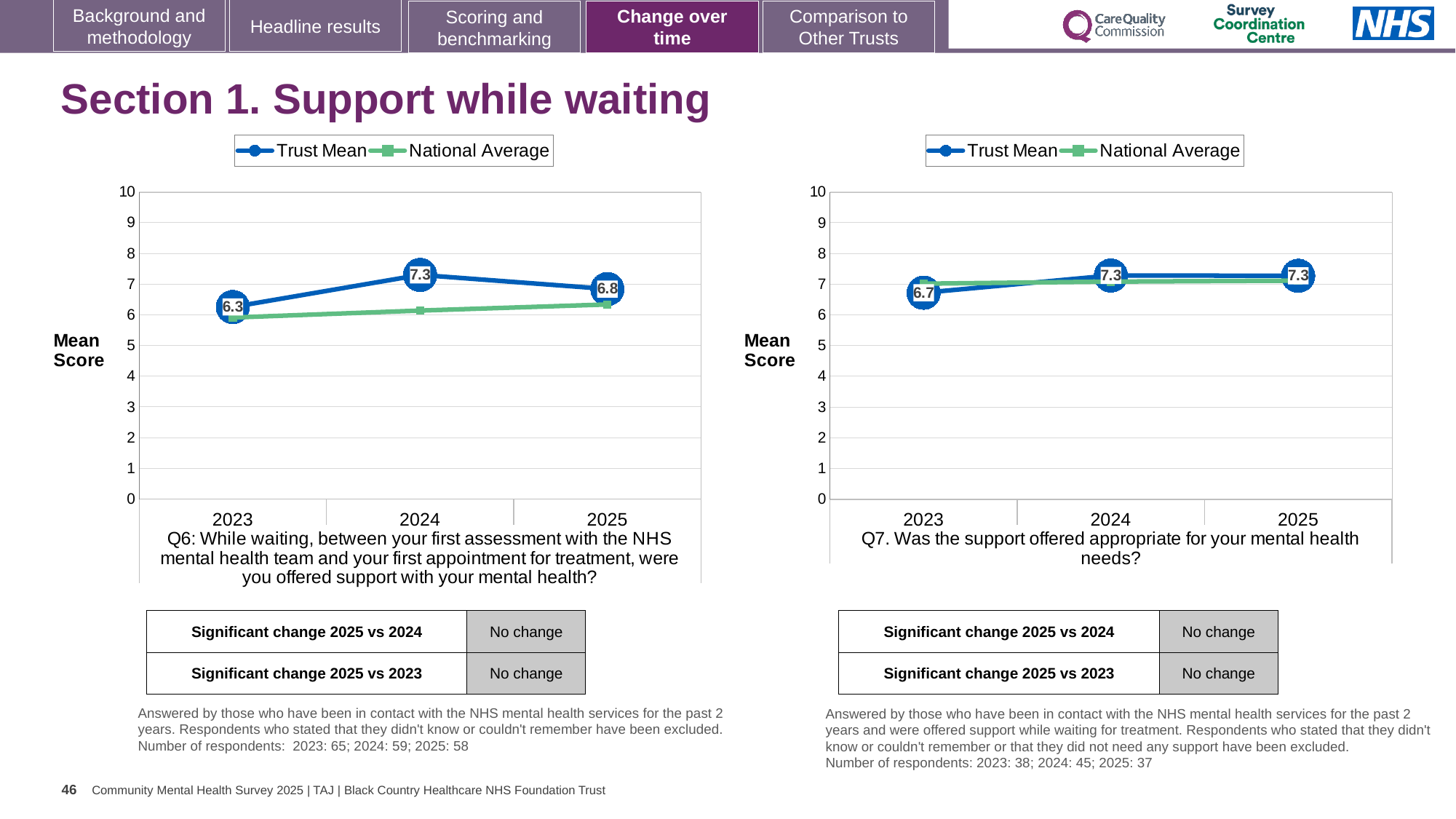
On the Q6 chart (left), which year has the highest Trust Mean score? 2024 On the Q6 chart (left), what is the Trust Mean score for 2024? 7.3 On the Q6 chart (left), what is the Trust Mean score for 2025? 6.8 On the Q7 chart (right), which year has the lowest Trust Mean score? 2023 How many series does the legend of the Q6 chart (left) list? 2 On the Q7 chart (right), what is the Trust Mean score for 2023? 6.7 What kind of chart is the Q7 chart (right)? Line chart On the Q6 chart (left), is the National Average value for 2025 greater or less than 7? less On the Q6 chart (left), which year has the lowest Trust Mean score? 2023 On the Q6 chart (left), what is the difference between the Trust Mean scores for 2024 and 2023? 1.0 On the Q7 chart (right), what is the difference between the Trust Mean scores for 2024 and 2023? 0.6 On the Q7 chart (right), is the National Average value for 2023 greater or less than 6? greater